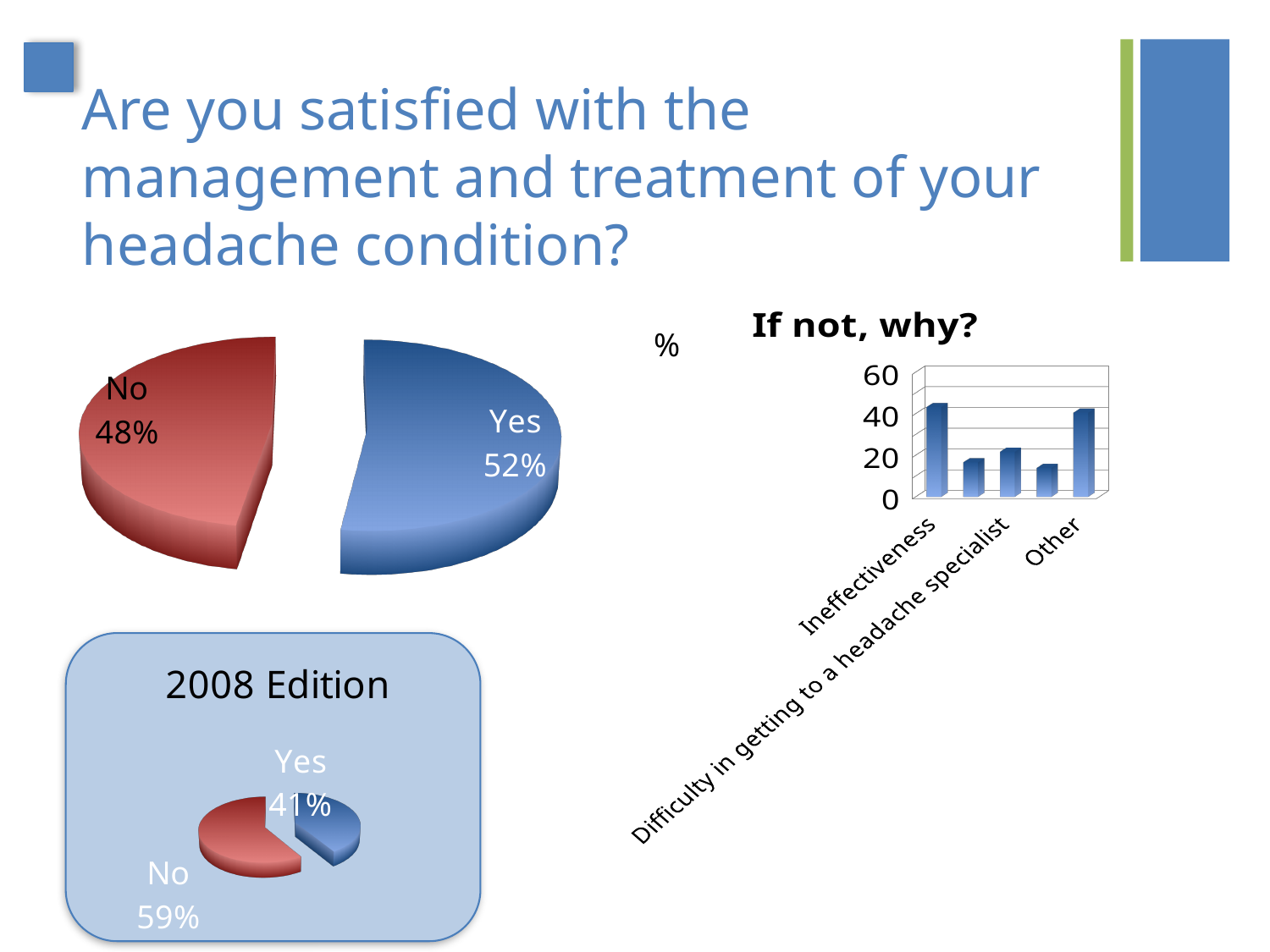
What is the title of the bar chart on the right of the slide? If not, why? In the large pie chart at the top left, what is the difference between the Yes and No shares? 4% In the 2008 Edition pie chart, what percentage answered Yes? 41% In the 2008 Edition pie chart, what percentage answered No? 59% In the 'If not, why?' chart, is the value for Ineffectiveness greater or less than 20? greater In the large pie chart at the top left, which answer has the larger share, Yes or No? Yes In the large pie chart at the top left, what percentage answered Yes? 52% How many slices does the 2008 Edition pie chart have? 2 In the 2008 Edition pie chart, which answer has the larger share? No What kind of chart is the 'If not, why?' chart? Bar chart In the large pie chart at the top left, what percentage answered No? 48% In the 2008 Edition pie chart, what is the difference between the No and Yes shares? 18%